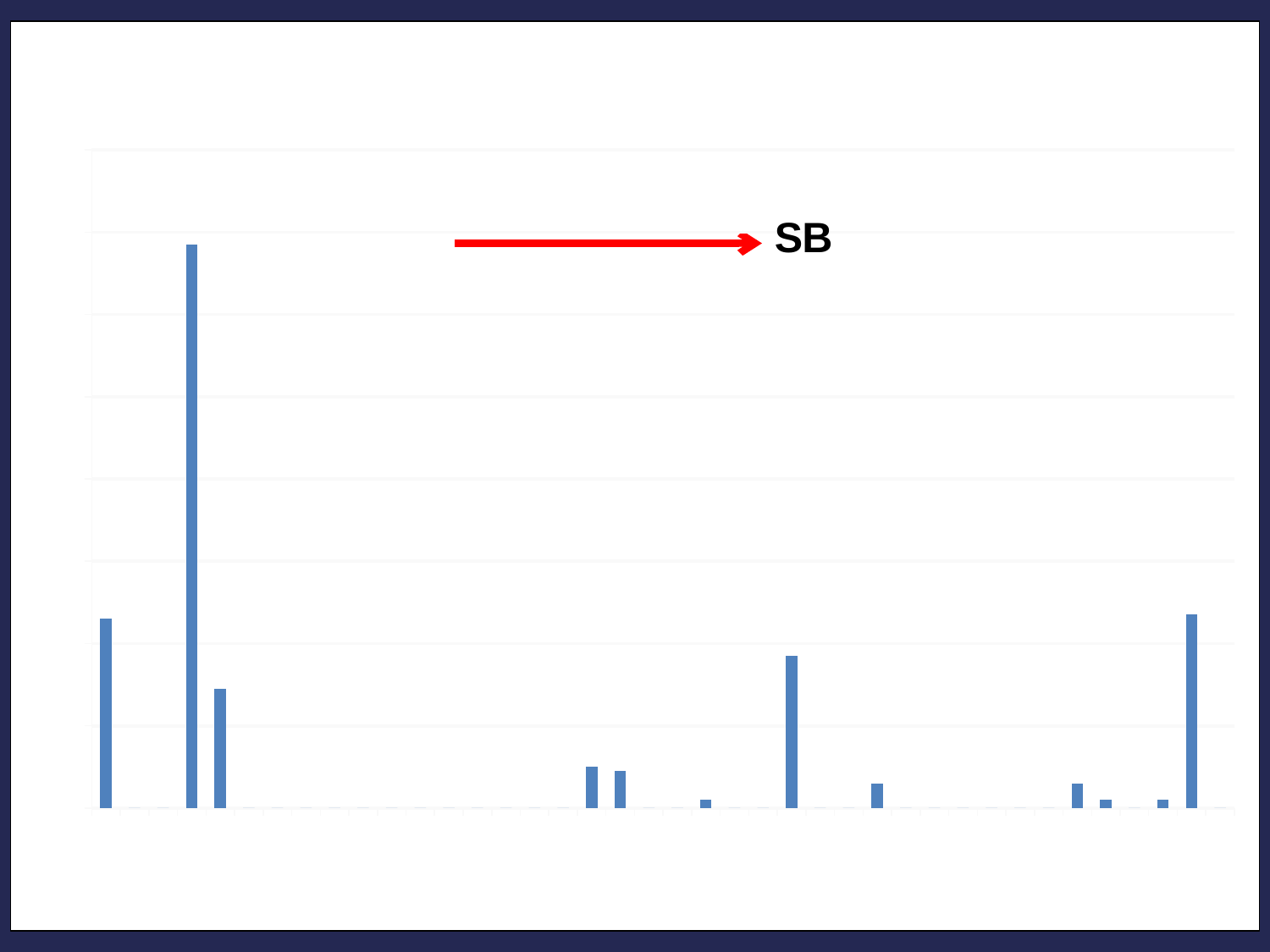
Which bar is taller: the second bar from the left or the rightmost bar? the second bar from the left Is the tallest bar in the chart located on the left side or the right side of the chart? left side How many visible bars are plotted in the chart? 12 What kind of chart is shown on the slide? bar chart What colour are the bars in the chart? blue What label does the red arrow on the chart point to? SB